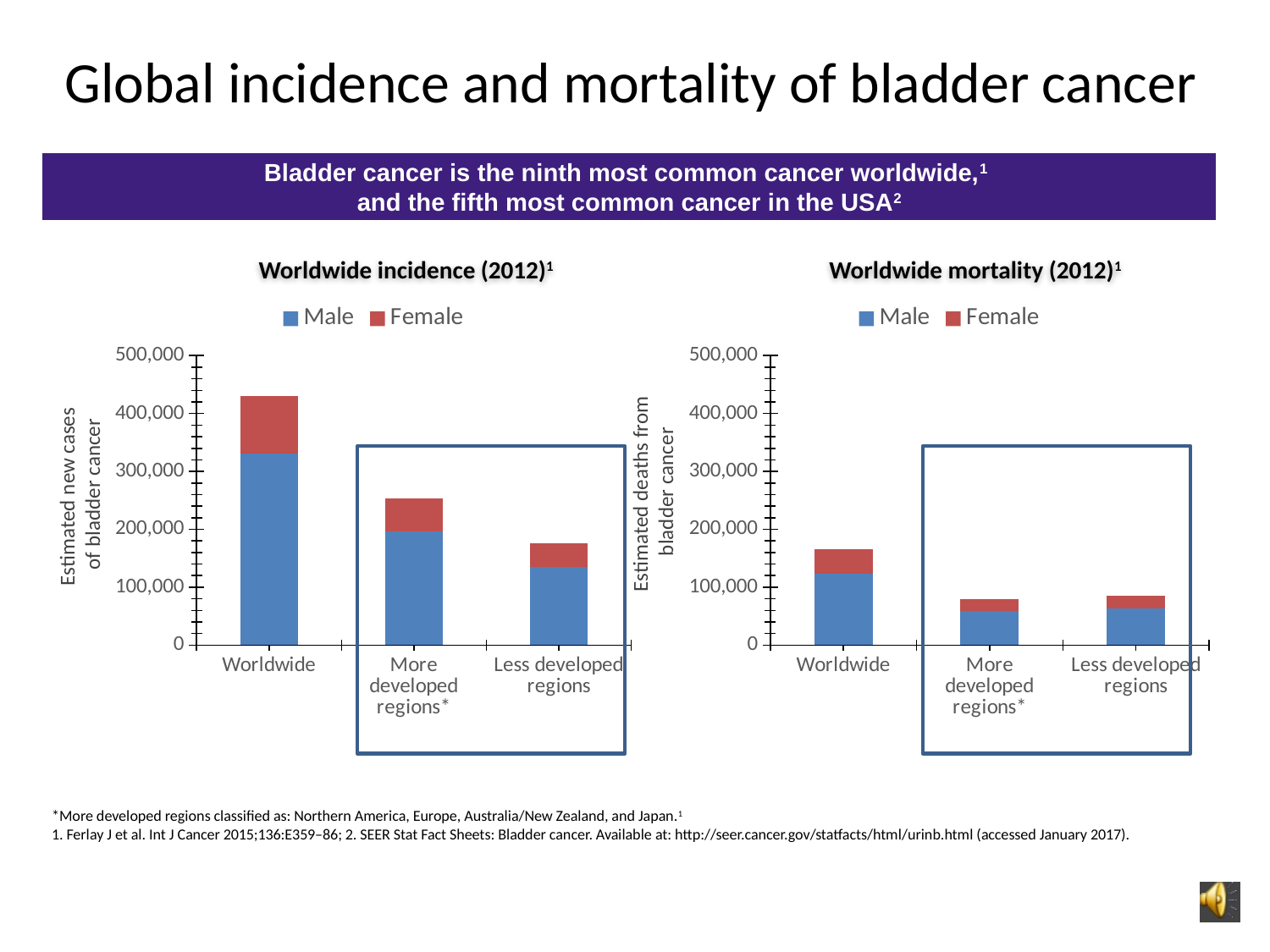
What is the y-axis label of the Worldwide mortality (2012) chart? Estimated deaths from bladder cancer In the Worldwide incidence (2012) chart, which category has the tallest stacked bar? Worldwide In the Worldwide mortality (2012) chart, is the total stacked value for Worldwide greater or less than 100,000? greater In the Worldwide incidence (2012) chart, which category has the shortest stacked bar? Less developed regions How many series does the legend of the Worldwide mortality (2012) chart list? 2 In the Worldwide incidence (2012) chart, which is larger for the Worldwide category: the Male segment or the Female segment? Male How many categories are shown on the x axis of the Worldwide incidence (2012) chart? 3 In the Worldwide incidence (2012) chart, is the total stacked value for Less developed regions greater or less than 200,000? less In the Worldwide incidence (2012) chart, is the total stacked value for Worldwide greater or less than 400,000? greater What kind of chart is the Worldwide incidence (2012) chart? Stacked bar chart In the Worldwide mortality (2012) chart, which category has the tallest stacked bar? Worldwide